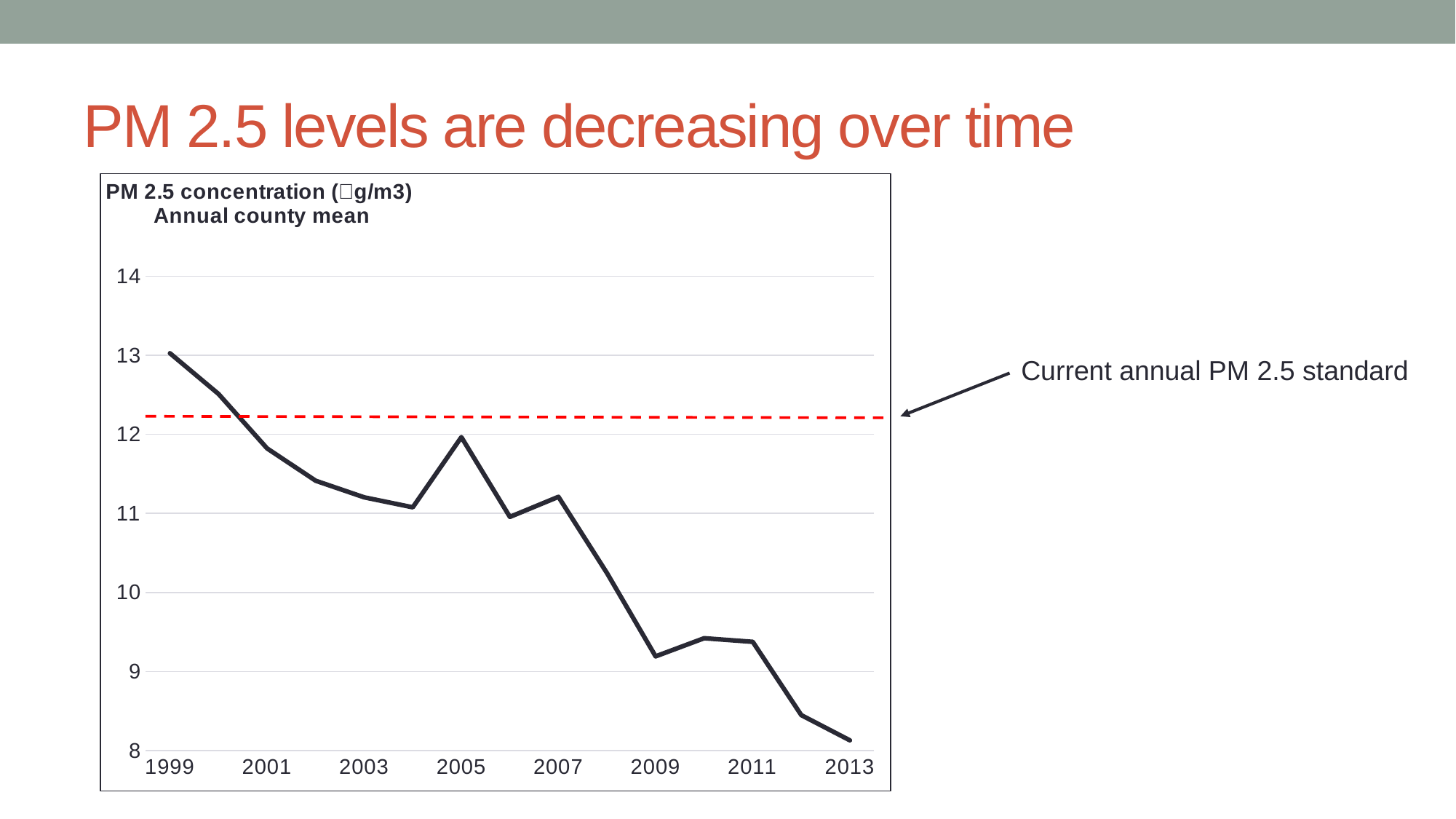
What is the title of the slide? PM 2.5 levels are decreasing over time Overall, do PM 2.5 values rise or fall from 1999 to 2013? fall Is the PM 2.5 value for 2005 greater or less than 11? greater Is the PM 2.5 value for 2013 greater or less than 9? less How many year labels are shown on the x axis? 8 What does the red dashed line on the chart represent? Current annual PM 2.5 standard What kind of chart is shown on the slide? line chart Is the PM 2.5 value for 2009 greater or less than 10? less Which year has the highest PM 2.5 annual county mean? 1999 Which year has the lowest PM 2.5 annual county mean? 2013 Which year has the larger PM 2.5 value, 2001 or 2011? 2001